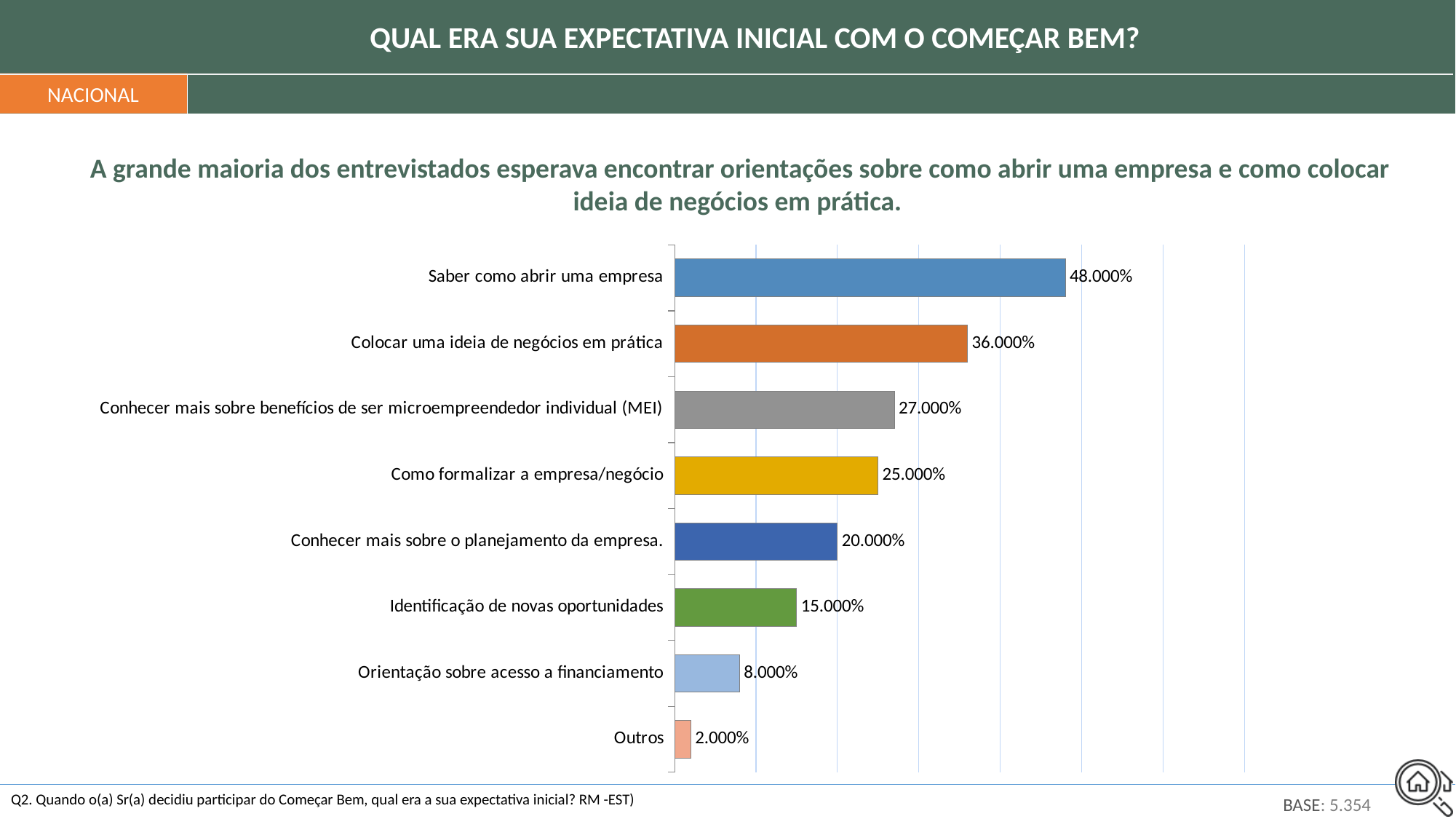
What is the value for "Orientação sobre acesso a financiamento"? 8.000% What is the difference between the values for "Saber como abrir uma empresa" and "Colocar uma ideia de negócios em prática"? 12.000% How many categories are shown in the chart? 8 What colour is the bar for "Como formalizar a empresa/negócio"? Yellow What kind of chart is shown on the slide? Bar chart Which is larger, the value for "Conhecer mais sobre o planejamento da empresa." or the value for "Identificação de novas oportunidades"? Conhecer mais sobre o planejamento da empresa. What is the difference between the values for "Conhecer mais sobre benefícios de ser microempreendedor individual (MEI)" and "Como formalizar a empresa/negócio"? 2.000% What is the value for "Identificação de novas oportunidades"? 15.000% Which category has the highest value? Saber como abrir uma empresa What is the value for "Saber como abrir uma empresa"? 48.000% What is the value for "Colocar uma ideia de negócios em prática"? 36.000% Which category has the lowest value? Outros